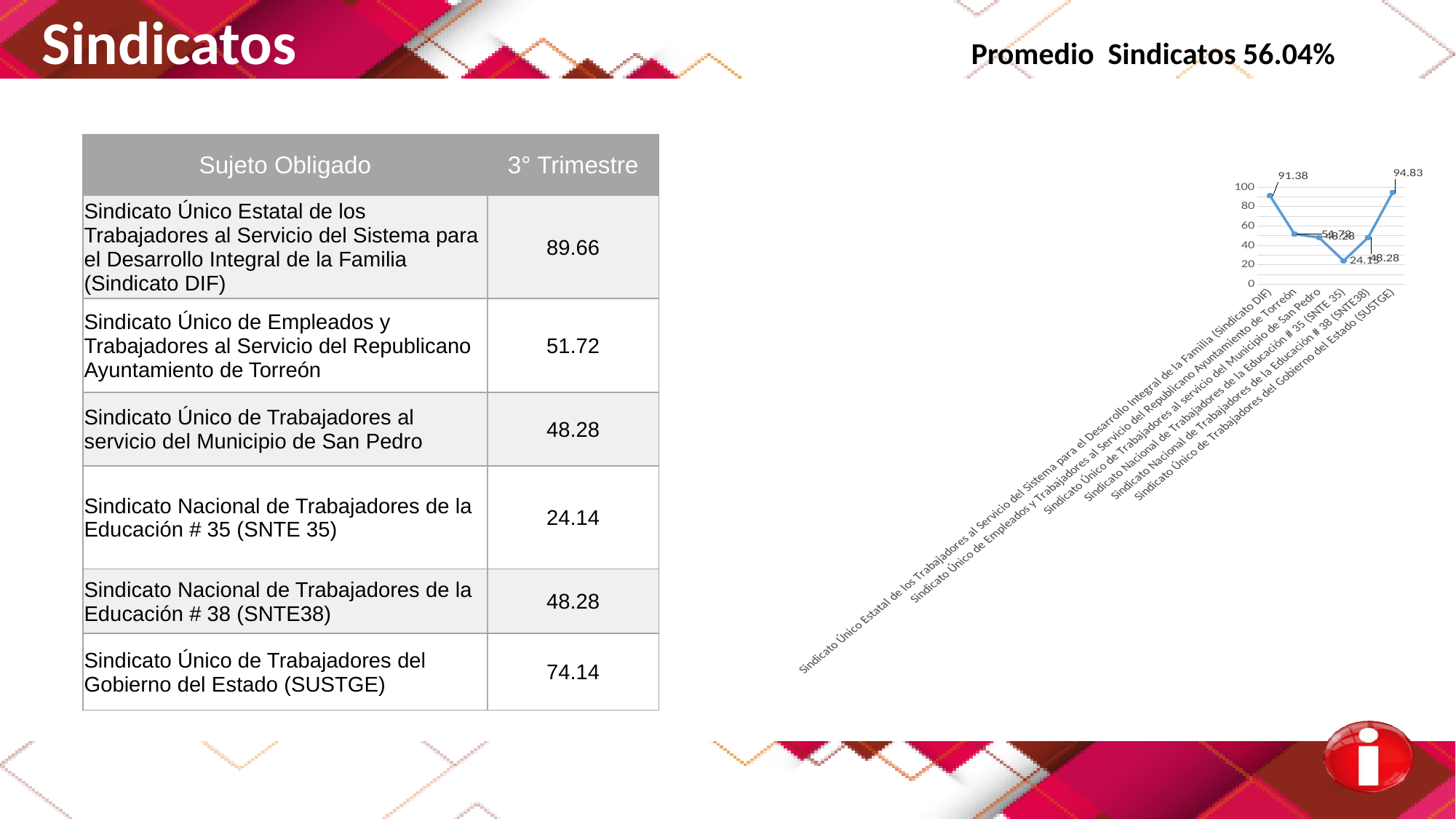
Which category has the lowest value on the chart? Sindicato Nacional de Trabajadores de la Educación # 35 (SNTE 35) On the chart, which is larger: the value for Sindicato DIF or the value for SUSTGE? SUSTGE Which category has the highest value on the chart? Sindicato Único de Trabajadores del Gobierno del Estado (SUSTGE) What kind of chart is shown on the slide? line chart What value does the chart show for Sindicato Único de Trabajadores del Gobierno del Estado (SUSTGE)? 94.83 How many data points are plotted on the chart? 6 On the chart, what is the difference between the value for SUSTGE and the value for Sindicato DIF? 3.45 Is the value for Sindicato Único de Empleados y Trabajadores al Servicio del Republicano Ayuntamiento de Torreón greater or less than 40? greater What is the maximum value shown on the chart's vertical axis? 100 Is the value for Sindicato Nacional de Trabajadores de la Educación # 35 (SNTE 35) greater or less than 40? less Is the value for Sindicato Único de Trabajadores al servicio del Municipio de San Pedro greater or less than 60? less What value does the chart show for Sindicato Único Estatal de los Trabajadores al Servicio del Sistema para el Desarrollo Integral de la Familia (Sindicato DIF)? 91.38